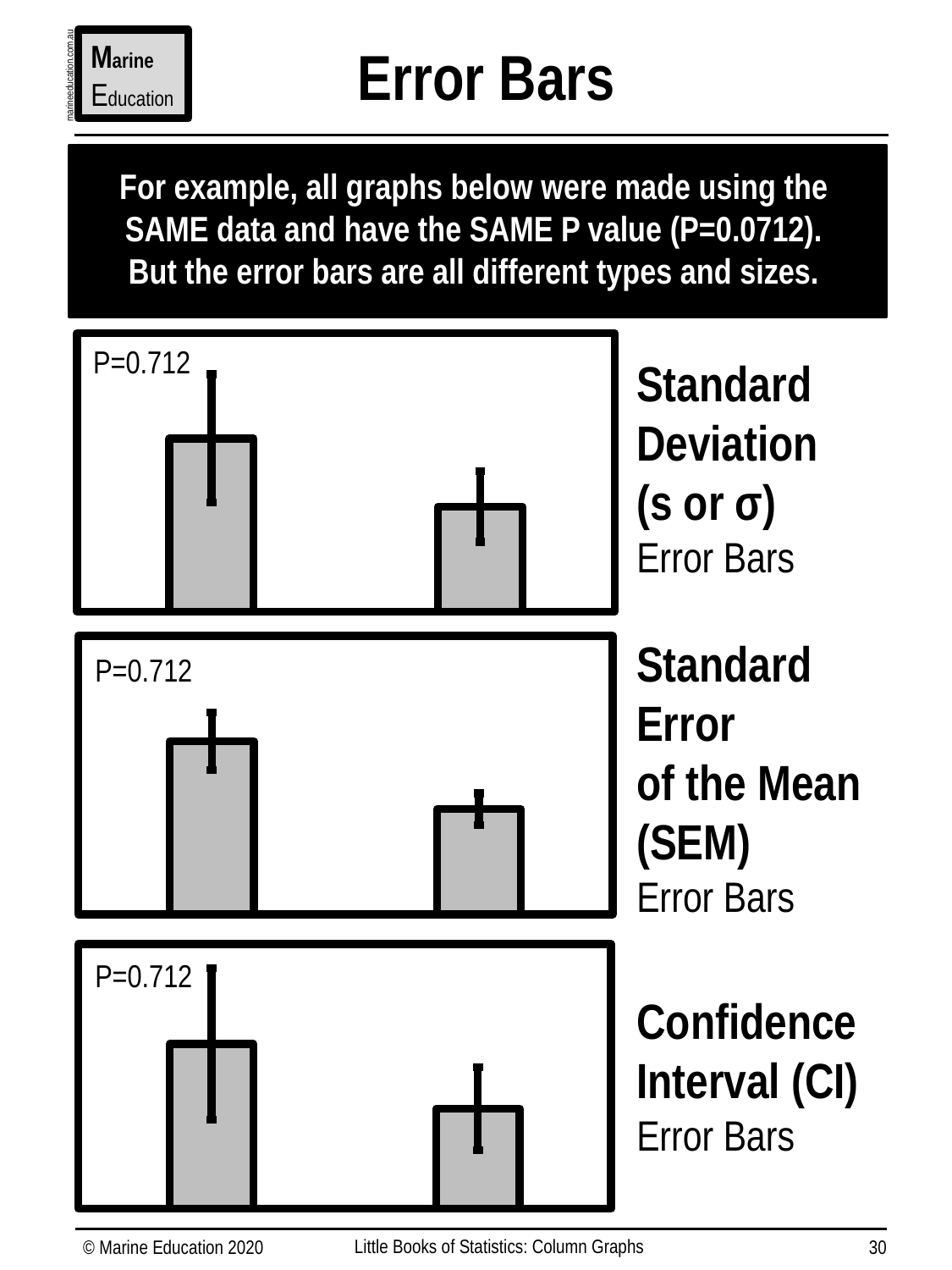
How many bars are plotted in the bottom chart (Confidence Interval Error Bars)? 2 Which of the three charts has the longest error bars: the Standard Deviation chart, the Standard Error of the Mean chart, or the Confidence Interval chart? the Confidence Interval chart In the middle chart (Standard Error of the Mean Error Bars), which bar is taller, the left bar or the right bar? the left bar What P value is printed inside the top chart (Standard Deviation Error Bars)? P=0.712 How many bars are plotted in the middle chart (Standard Error of the Mean Error Bars)? 2 In the top chart (Standard Deviation Error Bars), which bar is taller, the left bar or the right bar? the left bar What kind of chart is the top chart labelled Standard Deviation Error Bars? bar chart How many bars are plotted in the top chart (Standard Deviation Error Bars)? 2 In the bottom chart (Confidence Interval Error Bars), which bar is taller, the left bar or the right bar? the left bar In the middle chart (Standard Error of the Mean Error Bars), which bar is the tallest? the left bar In the bottom chart (Confidence Interval Error Bars), which bar is the shortest? the right bar